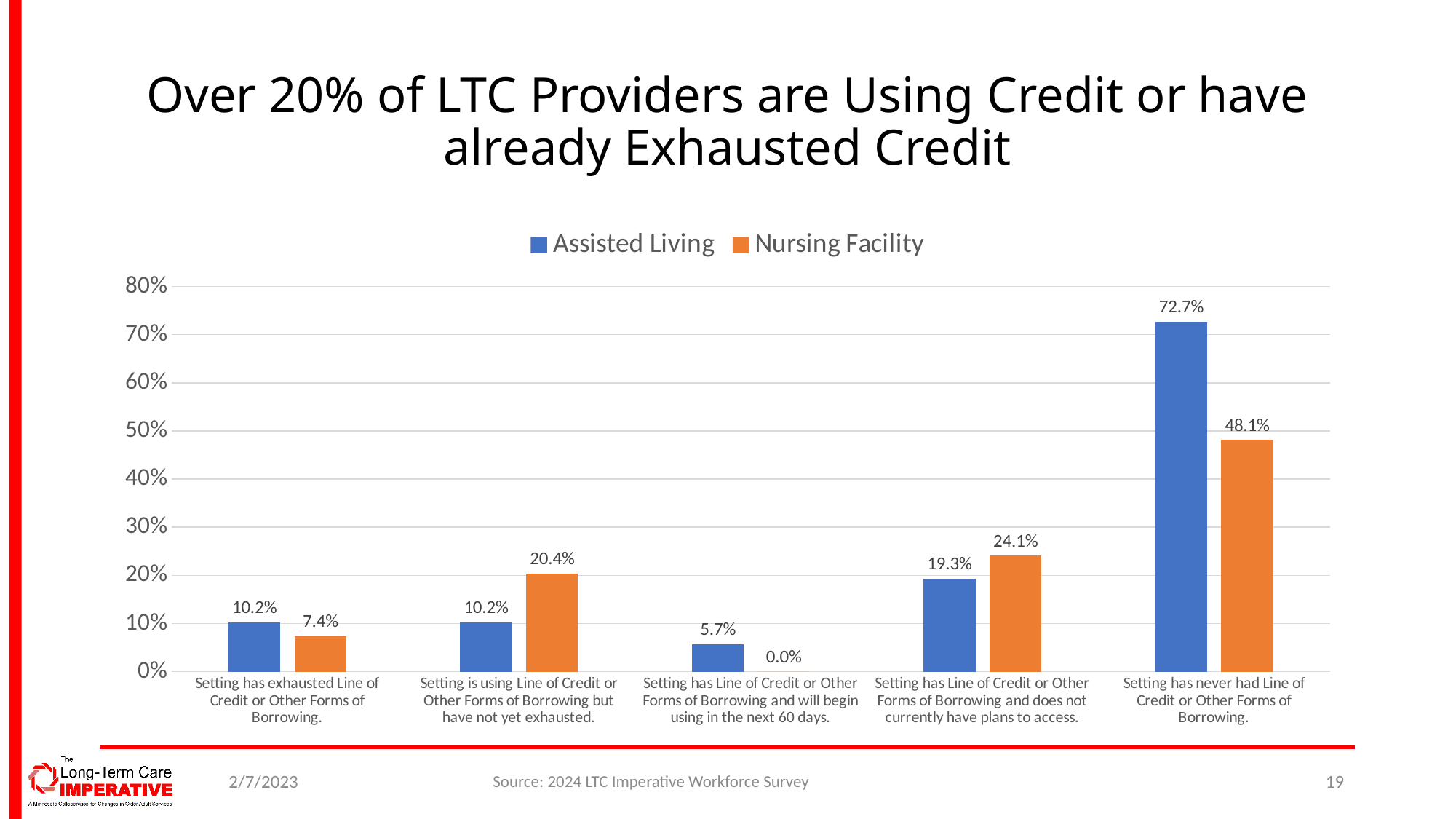
What is the difference between the Assisted Living and Nursing Facility values for 'Setting has never had Line of Credit or Other Forms of Borrowing.'? 24.6% Which category has the highest Nursing Facility value? Setting has never had Line of Credit or Other Forms of Borrowing. What is the Nursing Facility value for 'Setting has Line of Credit or Other Forms of Borrowing and will begin using in the next 60 days.'? 0.0% Is the Nursing Facility value for 'Setting has never had Line of Credit or Other Forms of Borrowing.' greater or less than 40%? greater What kind of chart is shown on the slide? Bar chart How many series does the legend list? 2 What is the Nursing Facility value for 'Setting is using Line of Credit or Other Forms of Borrowing but have not yet exhausted.'? 20.4% What is the Assisted Living value for 'Setting has Line of Credit or Other Forms of Borrowing and does not currently have plans to access.'? 19.3% What is the Assisted Living value for 'Setting has never had Line of Credit or Other Forms of Borrowing.'? 72.7% For 'Setting has exhausted Line of Credit or Other Forms of Borrowing.', which series has the larger value, Assisted Living or Nursing Facility? Assisted Living Which category has the lowest Assisted Living value? Setting has Line of Credit or Other Forms of Borrowing and will begin using in the next 60 days. How many categories are shown on the x axis? 5